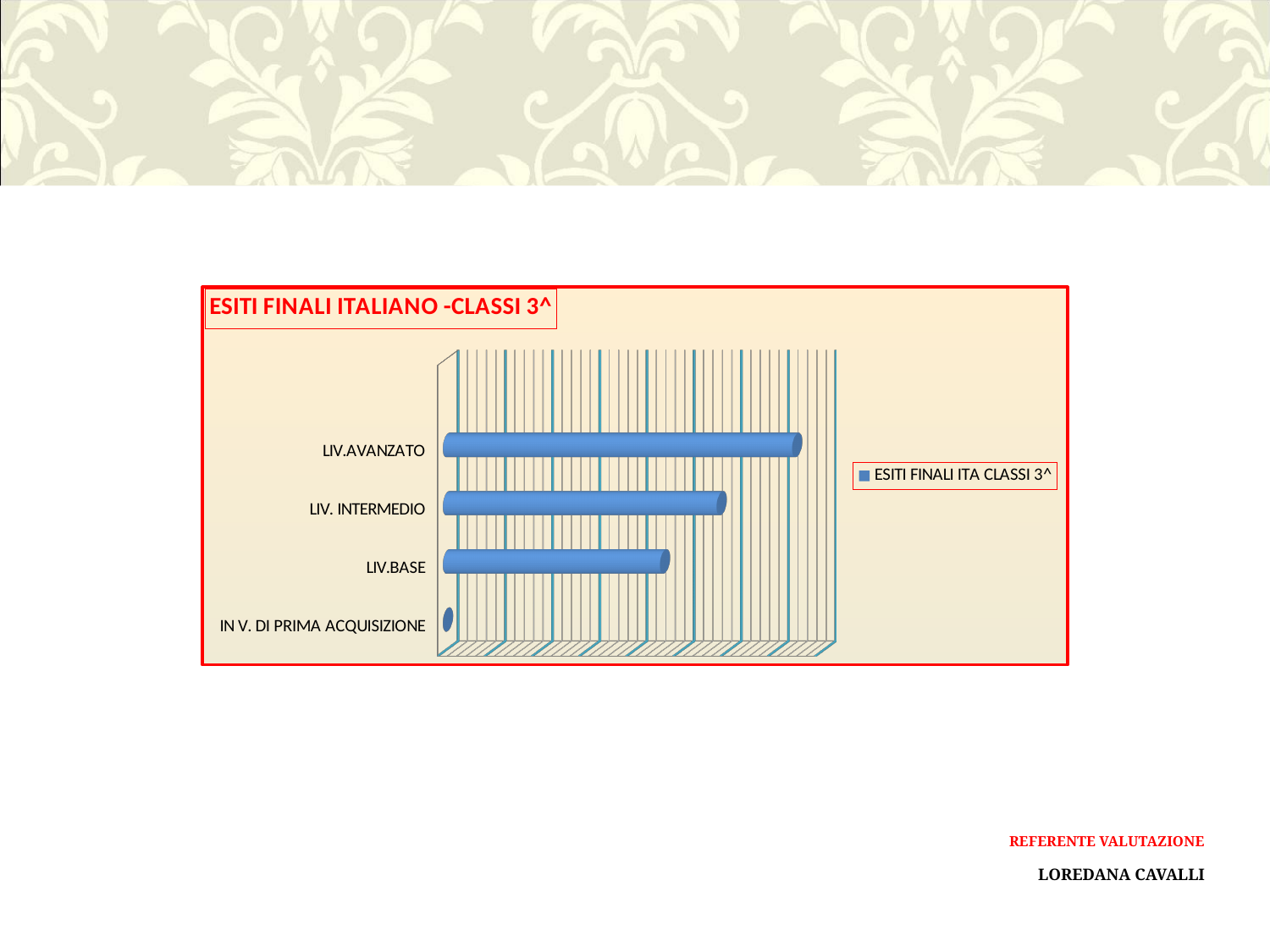
What kind of chart is shown on the slide? bar chart Which is larger, the value for LIV.AVANZATO or the value for LIV. INTERMEDIO? LIV.AVANZATO Which category has the highest value? LIV.AVANZATO Which is larger, the value for LIV. INTERMEDIO or the value for LIV.BASE? LIV. INTERMEDIO Which category has the lowest value? IN V. DI PRIMA ACQUISIZIONE Which is larger, the value for LIV.BASE or the value for IN V. DI PRIMA ACQUISIZIONE? LIV.BASE How many series does the legend list? 1 What is the title of the chart? ESITI FINALI ITALIANO -CLASSI 3^ Which category has the second-highest value? LIV. INTERMEDIO How many categories are plotted in the chart? 4 What is the name of the series shown in the legend? ESITI FINALI ITA CLASSI 3^